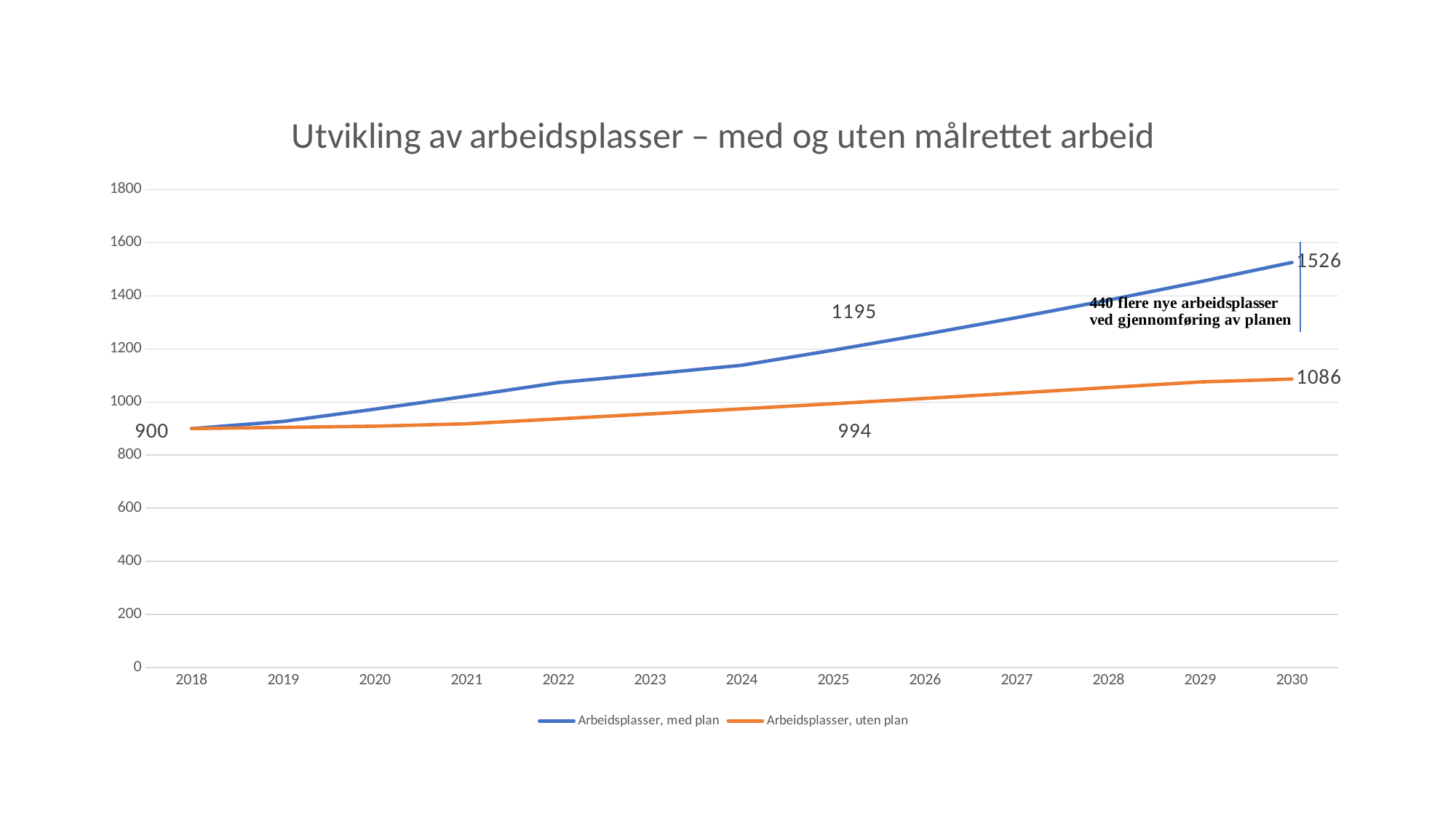
How many years are shown on the x axis? 13 Does the 'Arbeidsplasser, med plan' series rise or fall from 2018 to 2030? rise What is the value for 'Arbeidsplasser, med plan' in 2025? 1195 What is the value for 'Arbeidsplasser, uten plan' in 2030? 1086 What is the difference between 'Arbeidsplasser, med plan' and 'Arbeidsplasser, uten plan' in 2030? 440 What type of chart is shown on the slide? line chart What is the starting value of both series in 2018? 900 What is the value for 'Arbeidsplasser, uten plan' in 2025? 994 What is the title of the chart? Utvikling av arbeidsplasser – med og uten målrettet arbeid What is the value for 'Arbeidsplasser, med plan' in 2030? 1526 Which series has the higher value in 2025, 'Arbeidsplasser, med plan' or 'Arbeidsplasser, uten plan'? Arbeidsplasser, med plan How many series does the legend list? 2